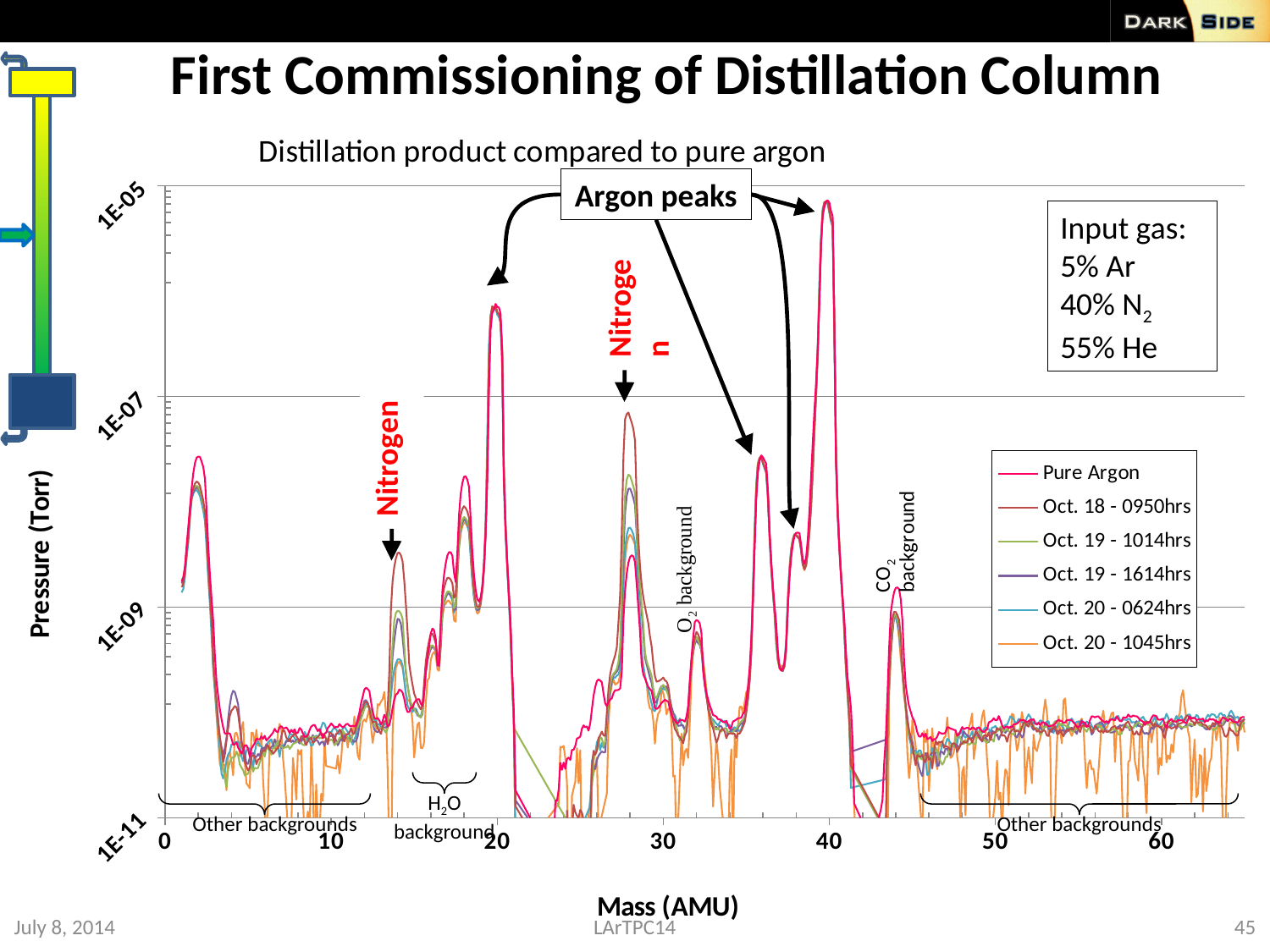
Is the Oct. 18 - 0950hrs peak at mass 14 AMU greater or less than 1E-09 Torr? greater Is the peak value at mass 20 AMU greater or less than 1E-07 Torr? greater What is the title of the chart? Distillation product compared to pure argon Is the peak value at mass 36 AMU greater or less than 1E-07 Torr? less How many series does the legend list? 6 Which peak is higher, the one at mass 36 AMU or the one at mass 38 AMU? Mass 36 AMU What is the label of the x axis? Mass (AMU) What kind of chart is shown on the slide? Line chart Which peak is higher, the one at mass 40 AMU or the one at mass 20 AMU? Mass 40 AMU At which mass (AMU) does the highest peak in the chart occur? 40